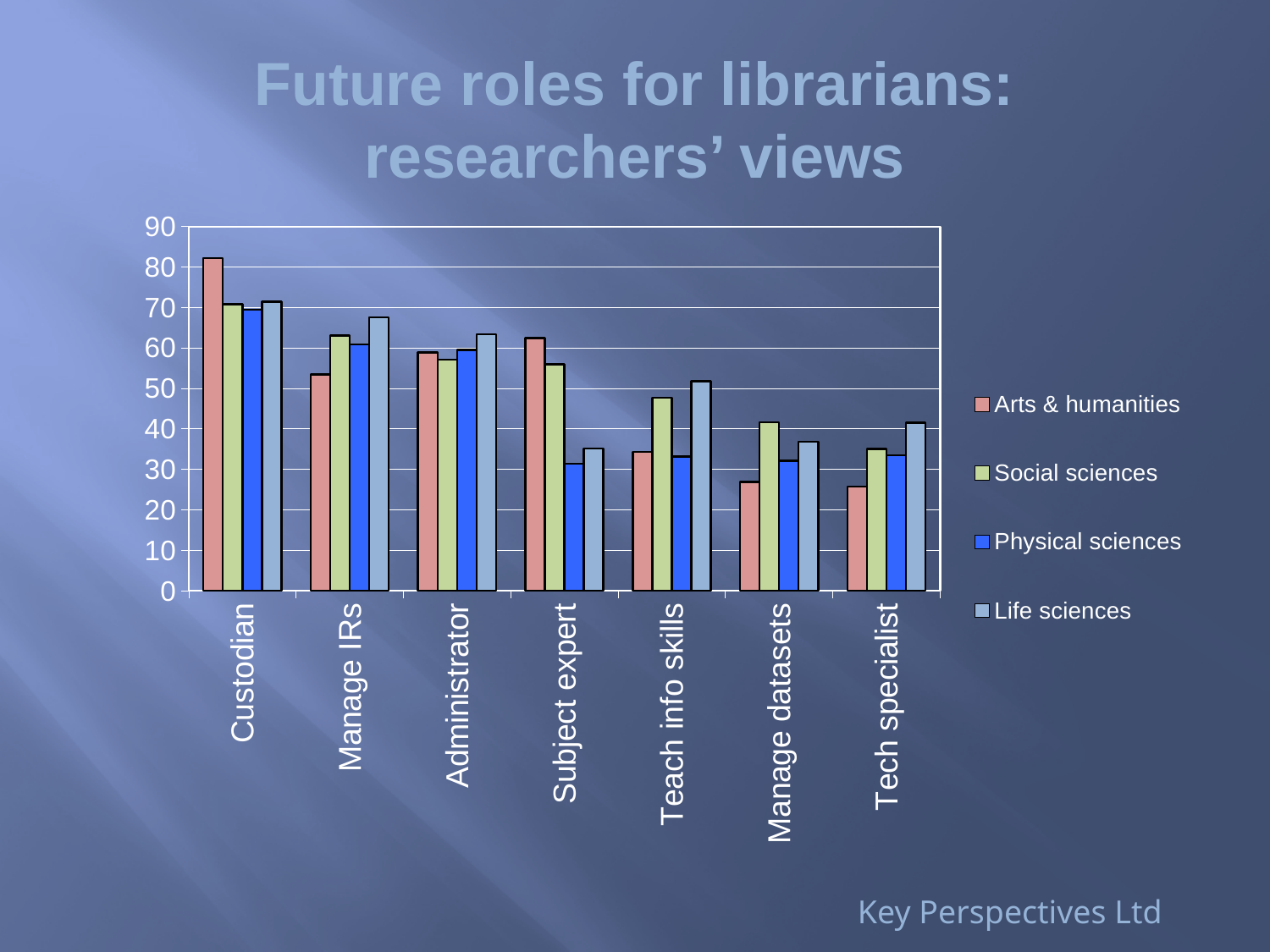
Is the Arts & humanities value for Custodian greater or less than 80? greater Which role has the highest Arts & humanities value? Custodian Do the Arts & humanities values generally rise or fall from Custodian to Tech specialist? fall Is the Life sciences value for Manage IRs greater or less than 60? greater Is the Physical sciences value for Subject expert greater or less than 40? less Which role has the lowest Social sciences value? Tech specialist How many series does the legend list? 4 What kind of chart is shown on the slide? Bar chart What colour represents Physical sciences in the legend? Blue For Teach info skills, which is larger: the Life sciences value or the Arts & humanities value? Life sciences How many role categories are shown on the x axis? 7 For Custodian, which is larger: the Arts & humanities value or the Social sciences value? Arts & humanities